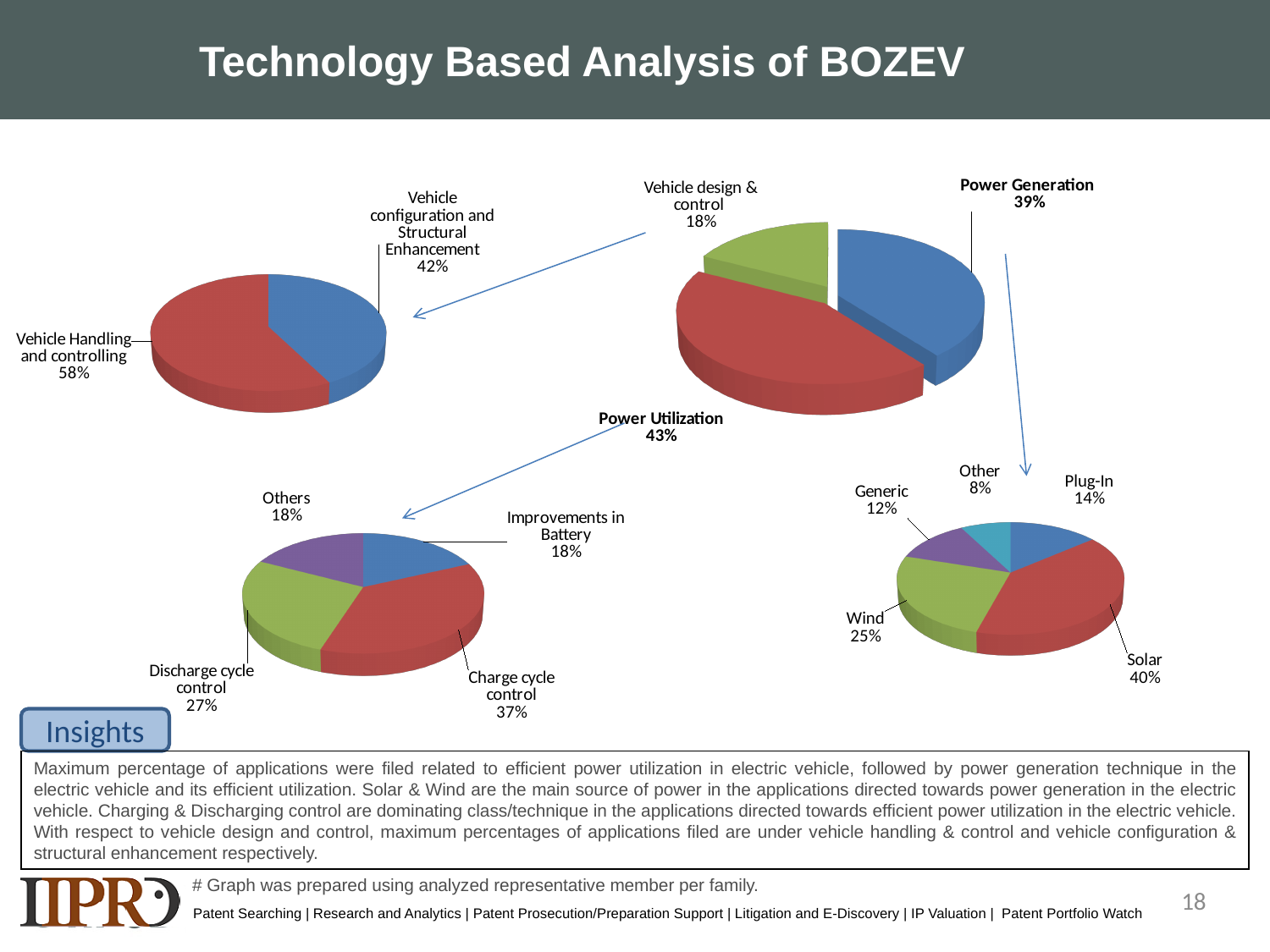
In the pie chart at the bottom right of the slide, which slice is the smallest? Other In the main pie chart at the top right of the slide, what is the difference between the Power Utilization and Power Generation shares? 4% In the pie chart at the top left of the slide, what share is labelled Vehicle Handling and controlling? 58% What kind of charts are shown on the slide? Pie charts In the pie chart at the bottom left of the slide, which slice is the largest? Charge cycle control In the main pie chart at the top right of the slide, which slice is the largest? Power Utilization In the pie chart at the bottom right of the slide, what share is labelled Wind? 25% In the pie chart at the bottom left of the slide, what share is labelled Discharge cycle control? 27% In the pie chart at the bottom left of the slide, how many slices are there? 4 In the pie chart at the bottom right of the slide, which is larger, Solar or Plug-In? Solar In the pie chart at the top left of the slide, how many slices are there? 2 In the main pie chart at the top right of the slide, what share is labelled Power Utilization? 43%